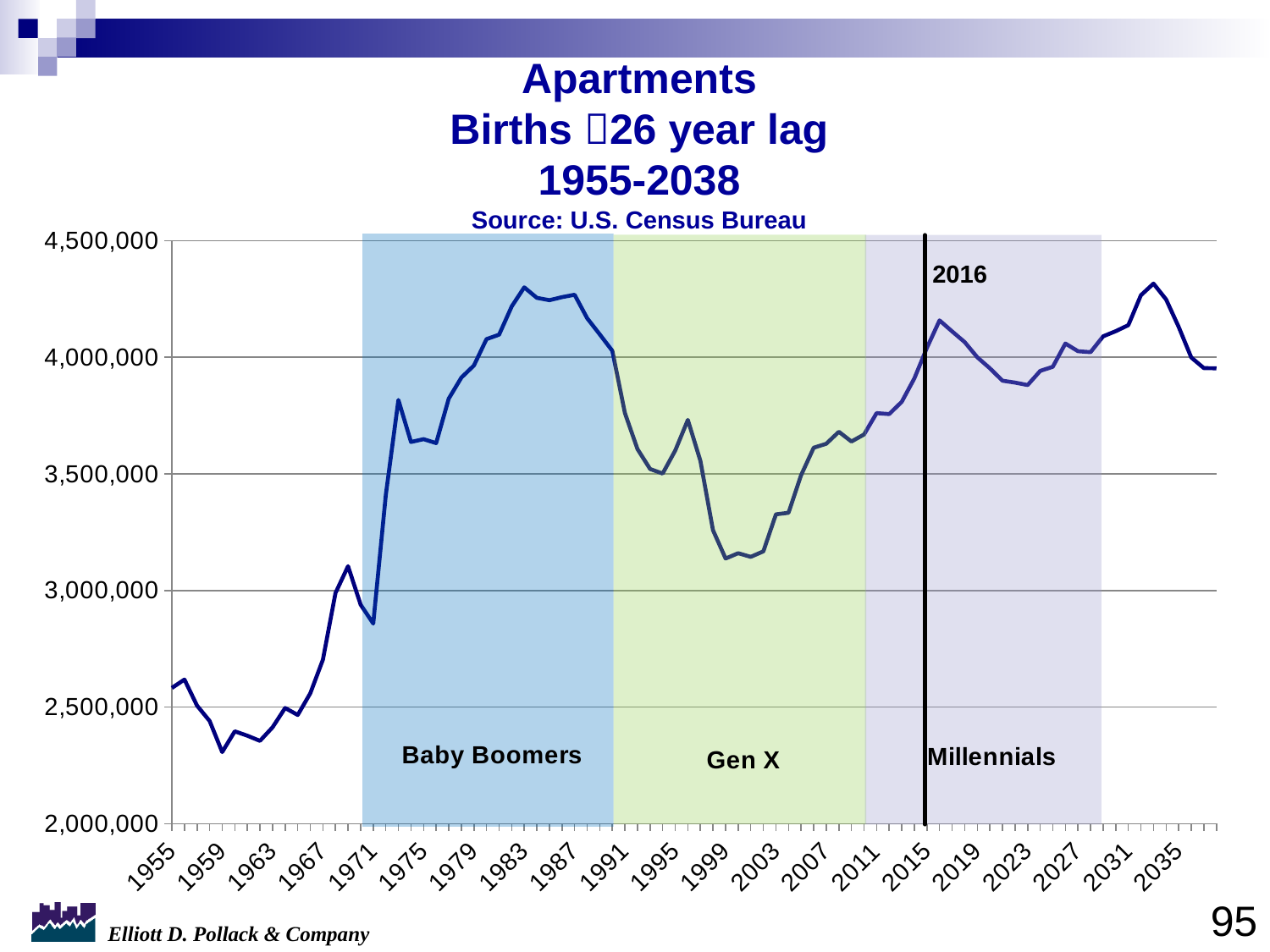
What kind of chart is shown on the slide? line chart Is the value for 2007 greater or less than 3,500,000? greater Do the values rise or fall between 1971 and 1983? rise What year is marked by the vertical black line on the chart? 2016 Is the value for 1983 greater or less than 4,000,000? greater Is the value for 1971 greater or less than 3,000,000? less Which generation label is shown in the blue shaded region of the chart? Baby Boomers Which is larger, the value for 1983 or the value for 2001? 1983 Do the values rise or fall between 1991 and 2001? fall